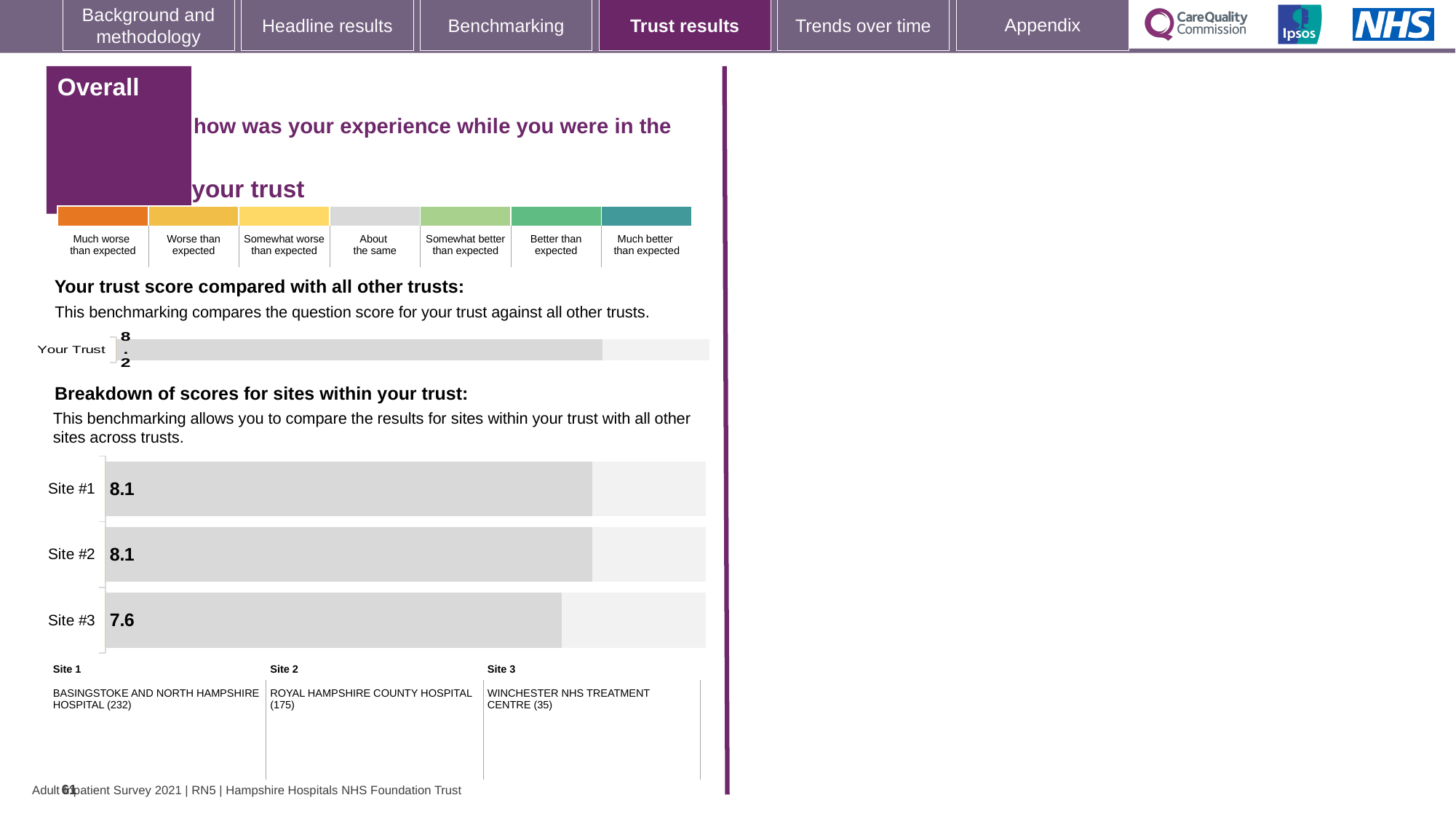
In the 'Breakdown of scores for sites within your trust' chart, which has the higher score, Site #2 or Site #3? Site #2 In the 'Breakdown of scores for sites within your trust' chart, what is the score for Site #2? 8.1 According to the site key below the chart, which hospital is Site 3? WINCHESTER NHS TREATMENT CENTRE (35) In the 'Breakdown of scores for sites within your trust' chart, what is the score for Site #1? 8.1 In the 'Your trust score compared with all other trusts' chart, what is the score shown for Your Trust? 8.2 In the 'Breakdown of scores for sites within your trust' chart, do the scores rise or fall from Site #1 to Site #3? Fall How many sites are shown in the 'Breakdown of scores for sites within your trust' chart? 3 In the 'Breakdown of scores for sites within your trust' chart, what is the score for Site #3? 7.6 In the 'Breakdown of scores for sites within your trust' chart, which site has the lowest score? Site #3 How many categories are shown in the colour key above the charts, from 'Much worse than expected' to 'Much better than expected'? 7 What kind of chart is the 'Breakdown of scores for sites within your trust' chart? Bar chart In the 'Breakdown of scores for sites within your trust' chart, what is the difference between the scores for Site #1 and Site #3? 0.5